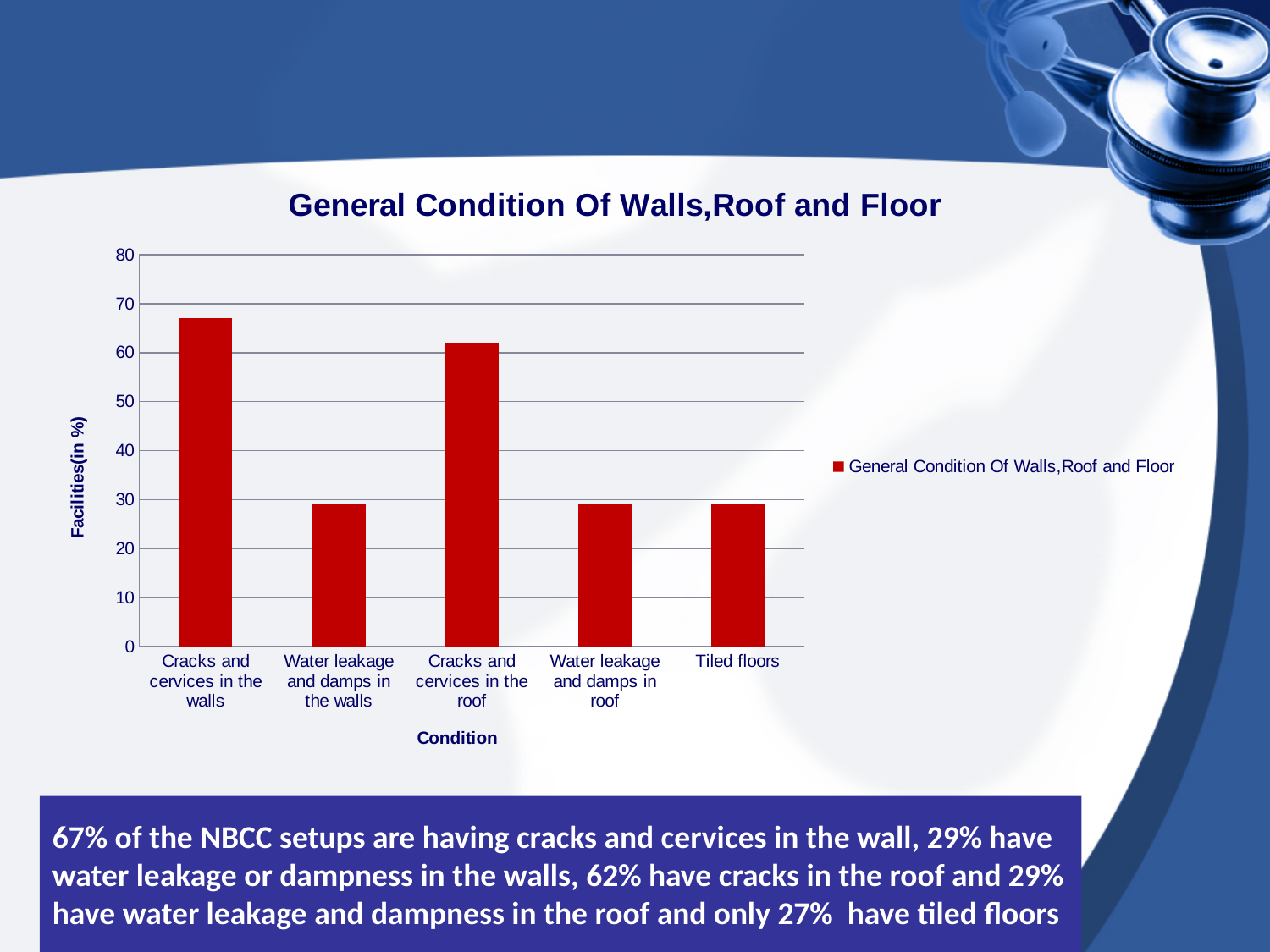
Is the value for Cracks and cervices in the walls greater or less than 60? greater Which condition has the highest bar? Cracks and cervices in the walls Which is larger: the value for Cracks and cervices in the walls or the value for Cracks and cervices in the roof? Cracks and cervices in the walls Which is larger: the value for Cracks and cervices in the roof or the value for Water leakage and damps in roof? Cracks and cervices in the roof What is the label of the vertical axis? Facilities(in %) Is the value for Cracks and cervices in the roof greater or less than 50? greater Is the value for Water leakage and damps in the walls greater or less than 40? less What is the title of the chart? General Condition Of Walls,Roof and Floor How many condition categories are plotted on the x axis? 5 How many series does the legend list? 1 What type of chart is shown on the slide? Bar chart